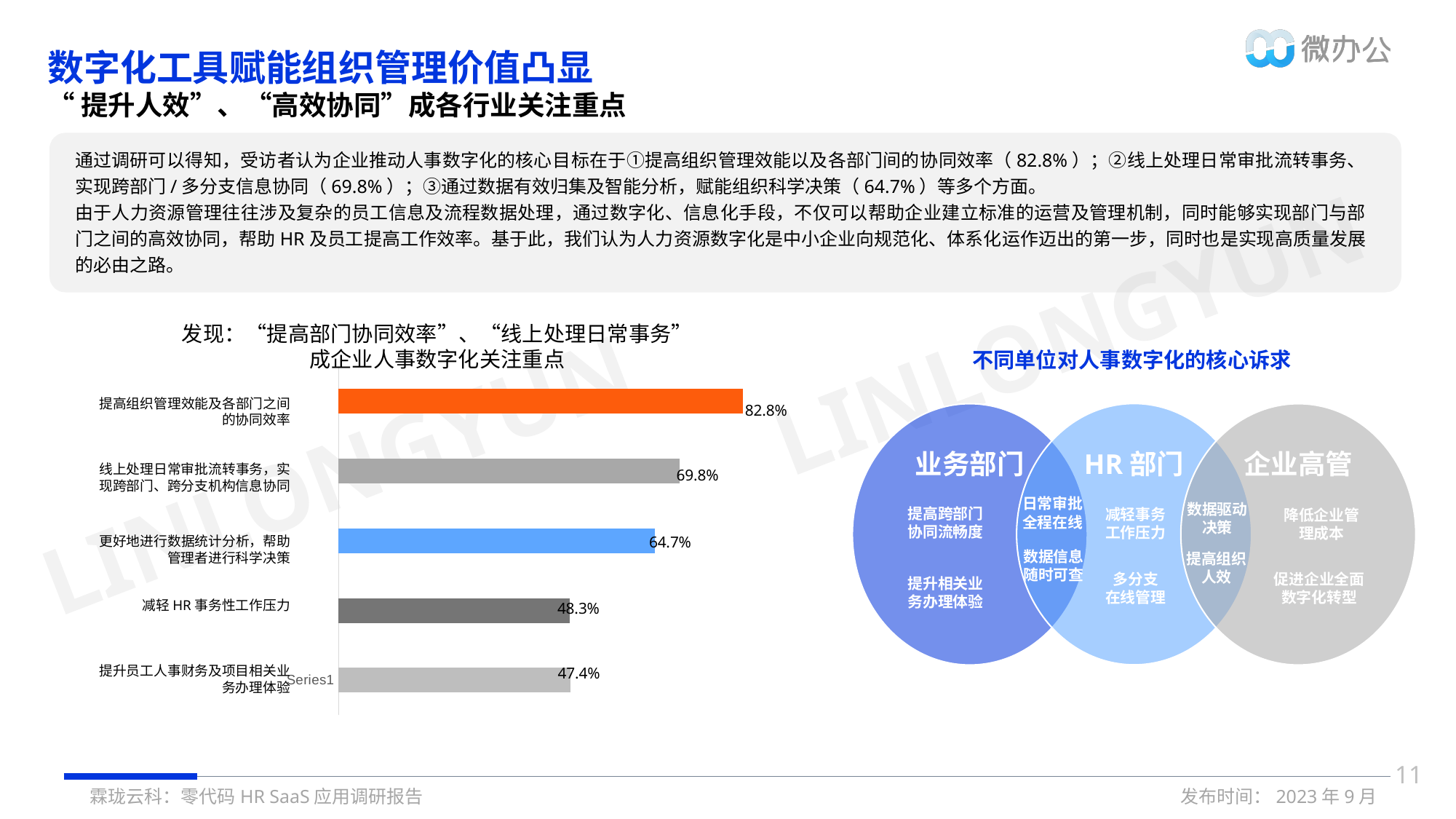
What is the value for 更好地进行数据统计分析，帮助管理者进行科学决策 in the bar chart? 64.7% What is the value for 提高组织管理效能及各部门之间的协同效率 in the bar chart? 82.8% What is the difference between the values for 线上处理日常审批流转事务，实现跨部门、跨分支机构信息协同 and 更好地进行数据统计分析，帮助管理者进行科学决策? 5.1% What is the value for 线上处理日常审批流转事务，实现跨部门、跨分支机构信息协同 in the bar chart? 69.8% Which category has the highest value in the bar chart? 提高组织管理效能及各部门之间的协同效率 Which category has the lowest value in the bar chart? 提升员工人事财务及项目相关业务办理体验 What is the value for 减轻 HR 事务性工作压力 in the bar chart? 48.3% What colour is the bar for 提高组织管理效能及各部门之间的协同效率 in the bar chart? orange Which is larger in the bar chart: 减轻 HR 事务性工作压力 or 提升员工人事财务及项目相关业务办理体验? 减轻 HR 事务性工作压力 What is the difference between the values for 提高组织管理效能及各部门之间的协同效率 and 线上处理日常审批流转事务，实现跨部门、跨分支机构信息协同? 13.0% How many categories does the bar chart show? 5 What kind of chart is shown on the left of the slide? bar chart